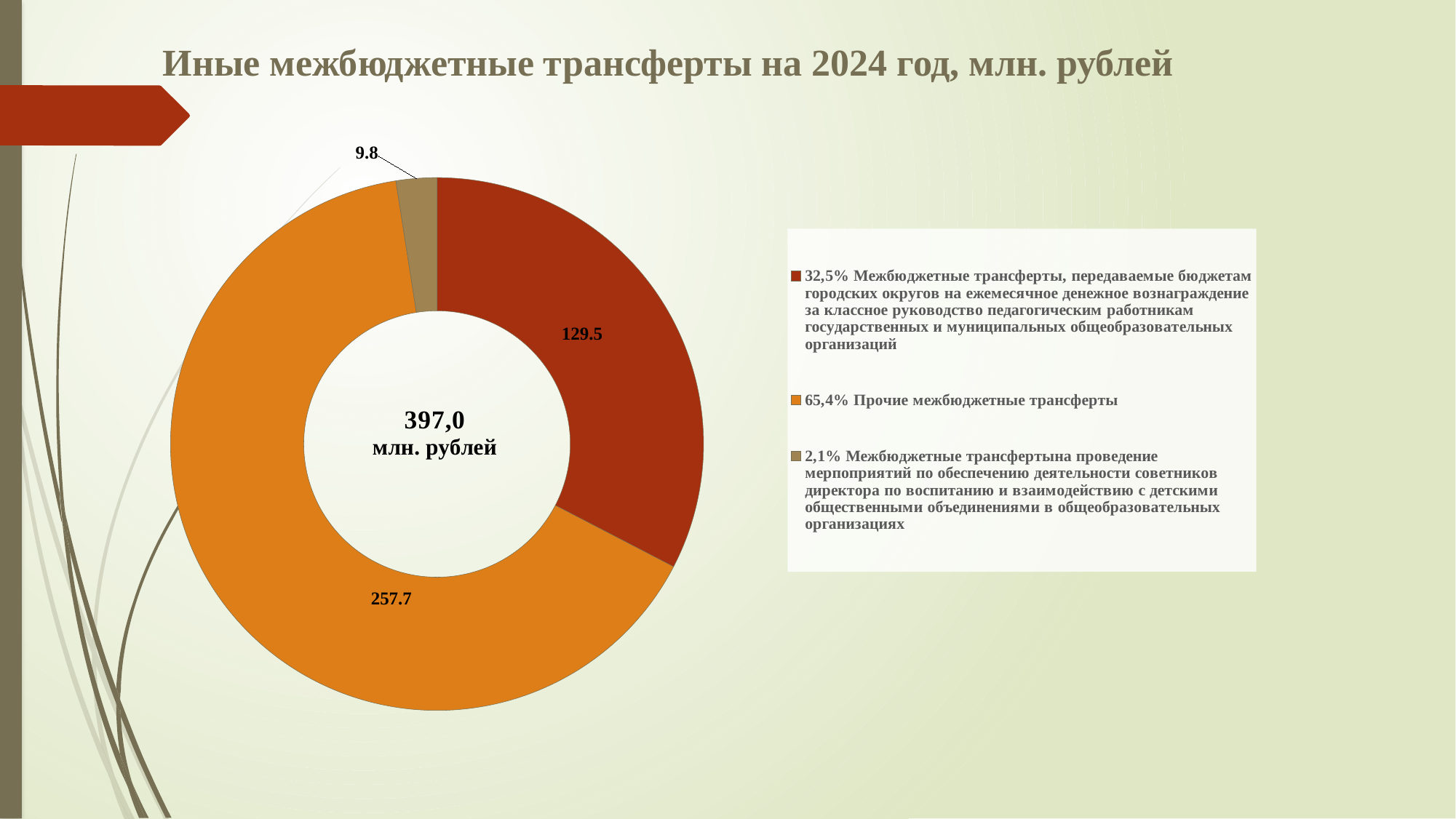
What total value is shown in the centre of the chart? 397,0 млн. рублей Which category has the largest slice in the chart? Прочие межбюджетные трансферты What type of chart is shown on the slide? Doughnut chart What share of the chart does "Прочие межбюджетные трансферты" represent? 65,4% What is the difference between the value for "Прочие межбюджетные трансферты" and the value for the slice for classroom leadership payments (129.5)? 128.2 What value is shown for the slice "Прочие межбюджетные трансферты"? 257.7 How many slices does the chart have? 3 What value is shown for the slice "Межбюджетные трансферты, передаваемые бюджетам городских округов на ежемесячное денежное вознаграждение за классное руководство..."? 129.5 What value is shown for the slice "Межбюджетные трансферты на проведение мероприятий по обеспечению деятельности советников директора по воспитанию..."? 9.8 Which is larger: the slice for "Прочие межбюджетные трансферты" or the slice for classroom leadership payments to city district budgets? Прочие межбюджетные трансферты What share of the chart does the slice for advisors to the director on education (советников директора по воспитанию) represent? 2,1%